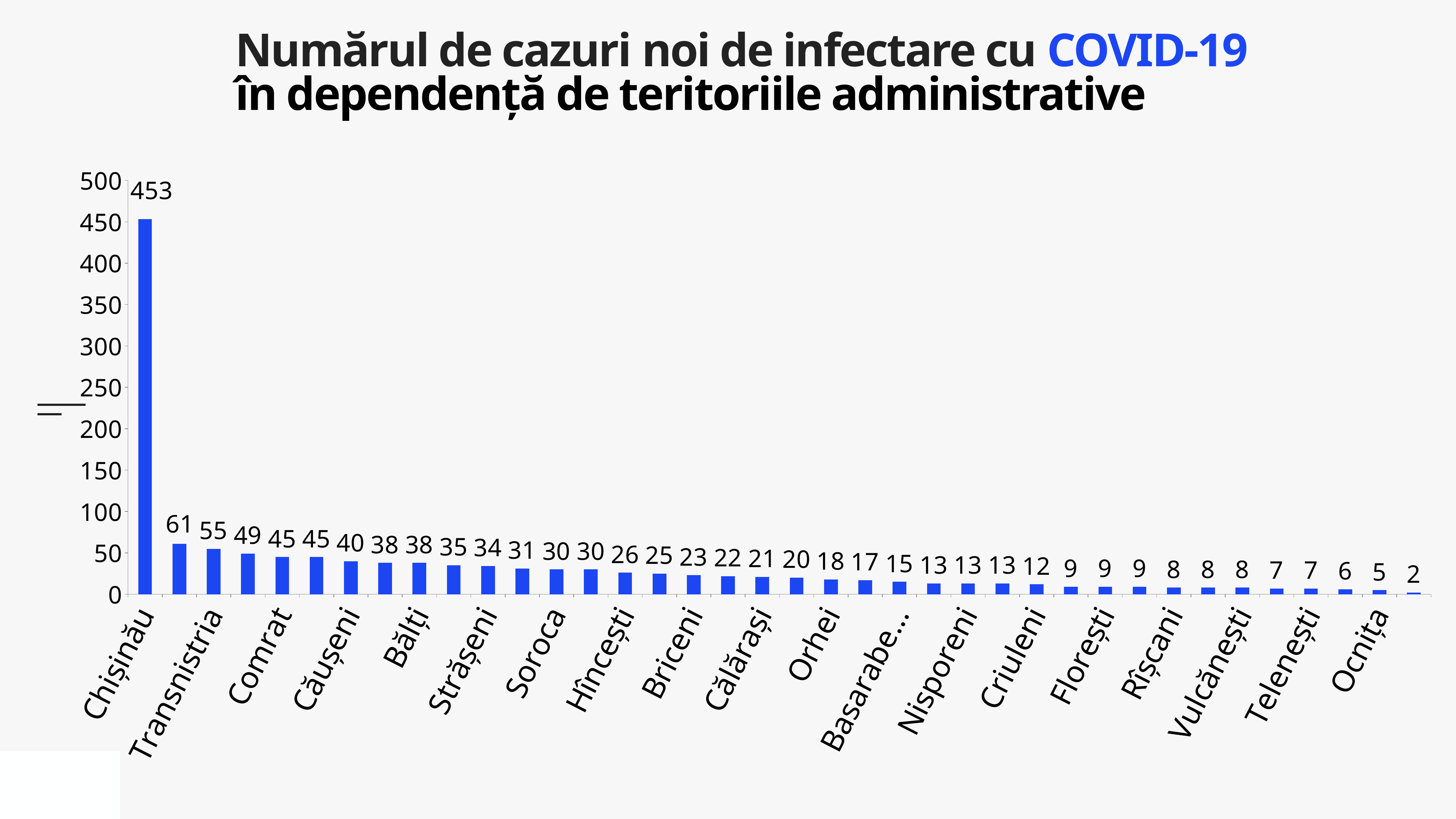
What type of chart is shown on the slide? bar chart What is the value shown for Soroca? 30 Which has a larger value, Chișinău or Transnistria? Chișinău What is the difference between the values for Chișinău and Orhei? 435 Which administrative territory has the highest number of new cases? Chișinău What is the value shown for Orhei? 18 What is the value shown for Ocnița? 5 Is the value for Chișinău greater or less than 400? greater What is the number of new COVID-19 cases for Chișinău? 453 Do the values rise or fall from left to right along the x axis? fall What is the title of the chart? Numărul de cazuri noi de infectare cu COVID-19 în dependență de teritoriile administrative How many bars are plotted in the chart? 38